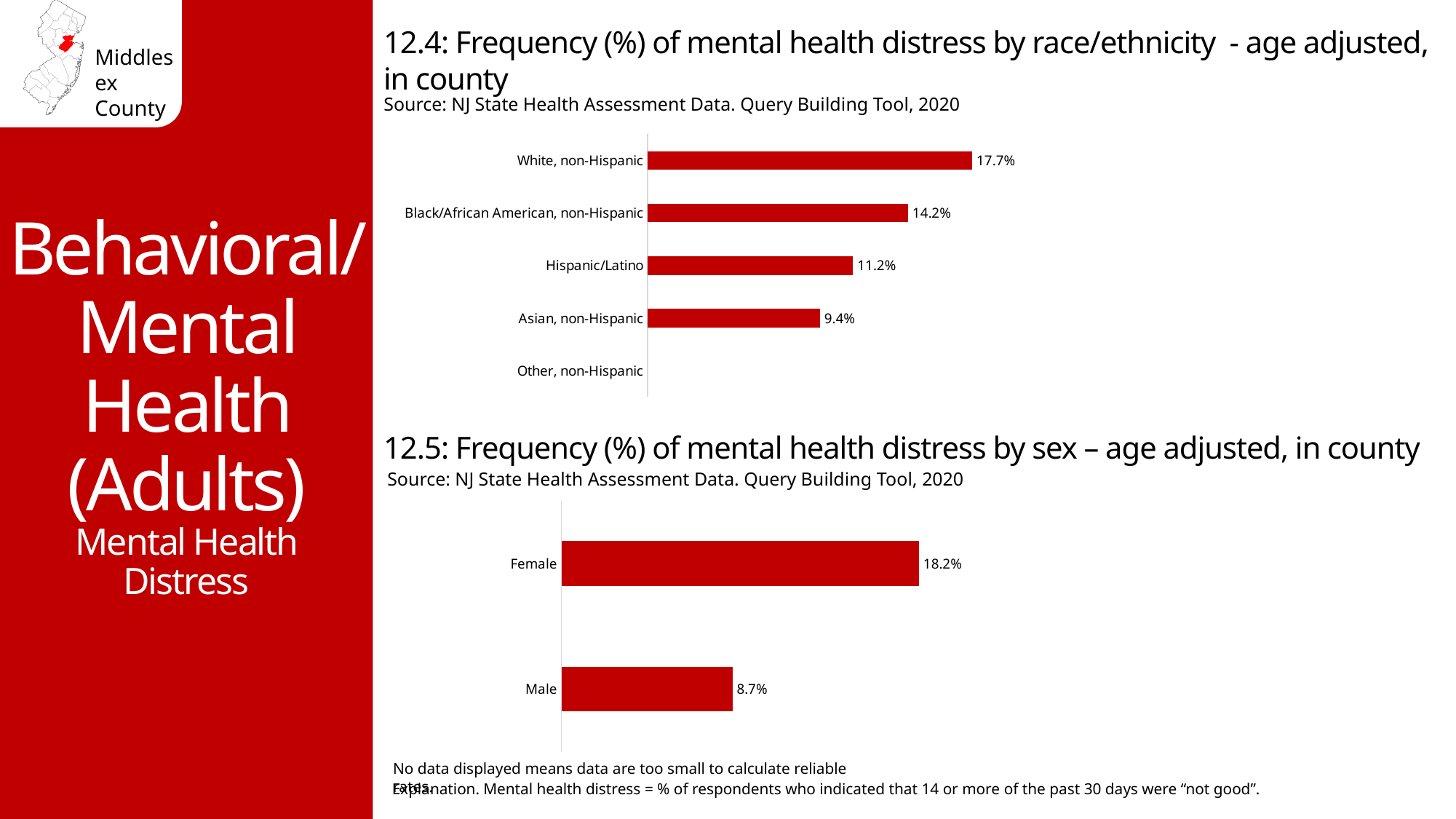
In chart 12.5 (mental health distress by sex), what is the value for Male? 8.7% In chart 12.4 (mental health distress by race/ethnicity), what is the value for Hispanic/Latino? 11.2% In chart 12.4 (mental health distress by race/ethnicity), how many race/ethnicity categories are listed on the axis? 5 In chart 12.4 (mental health distress by race/ethnicity), which group with a displayed value has the lowest value? Asian, non-Hispanic In chart 12.4 (mental health distress by race/ethnicity), what is the value for White, non-Hispanic? 17.7% In chart 12.5 (mental health distress by sex), what is the difference between the Female and Male values? 9.5% In chart 12.4 (mental health distress by race/ethnicity), what is the difference between the values for White, non-Hispanic and Black/African American, non-Hispanic? 3.5% In chart 12.5 (mental health distress by sex), what is the value for Female? 18.2% What kind of chart is chart 12.5 (mental health distress by sex)? Bar chart In chart 12.4 (mental health distress by race/ethnicity), which category has no bar displayed? Other, non-Hispanic In chart 12.4 (mental health distress by race/ethnicity), which race/ethnicity group has the highest value? White, non-Hispanic In chart 12.4 (mental health distress by race/ethnicity), which is larger: the value for Black/African American, non-Hispanic or Hispanic/Latino? Black/African American, non-Hispanic